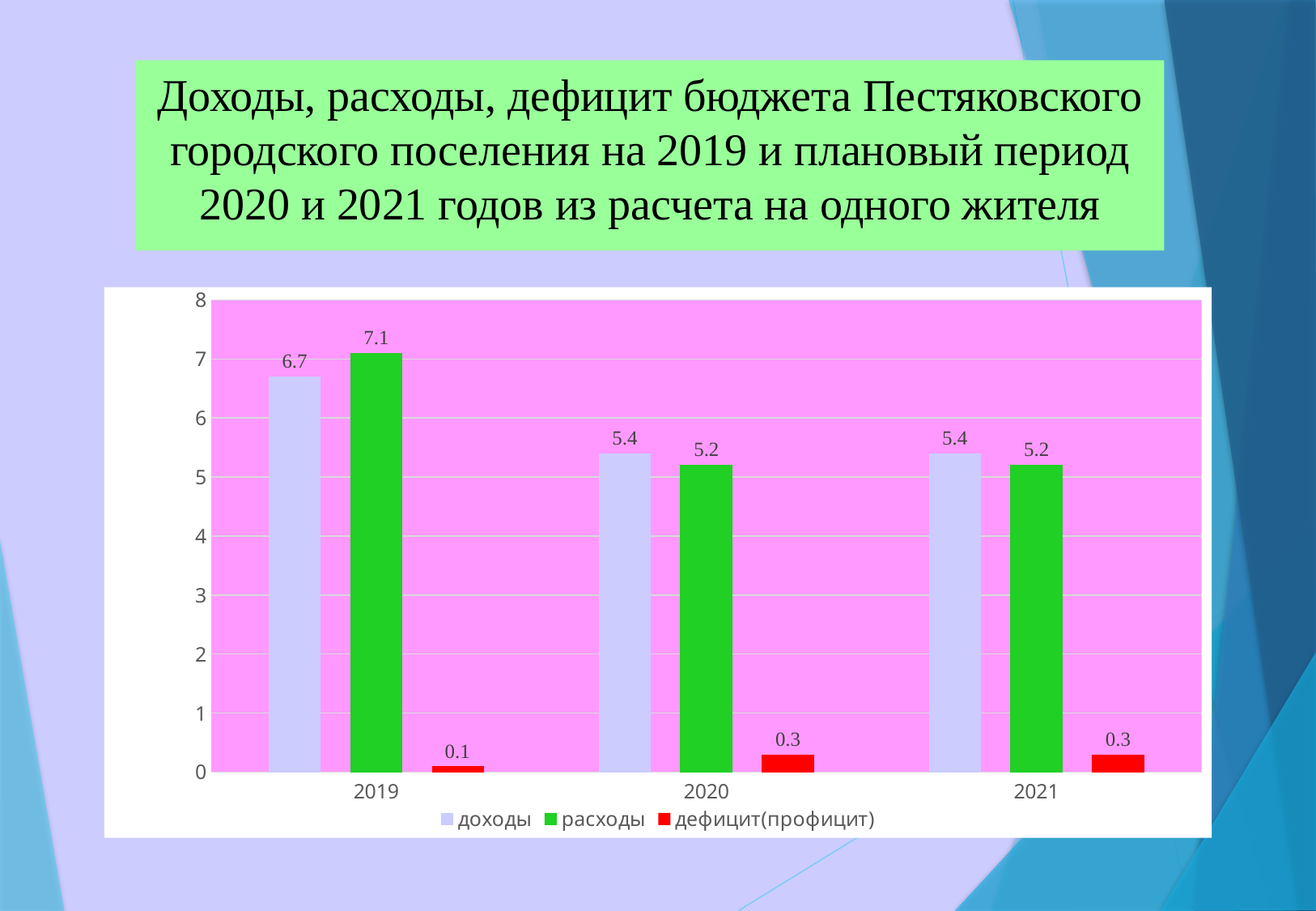
In which year is дефицит(профицит) lowest? 2019 What is the value of расходы for 2019? 7.1 What is the value of доходы for 2019? 6.7 What is the difference between расходы and доходы in 2019? 0.4 Which is larger in 2020, доходы or расходы? доходы What is the value of дефицит(профицит) for 2020? 0.3 What kind of chart is shown on the slide? bar chart How many series does the legend list? 3 What is the value of доходы for 2021? 5.4 Which colour represents расходы in the chart? green In which year is расходы highest? 2019 How many years are shown on the x axis? 3